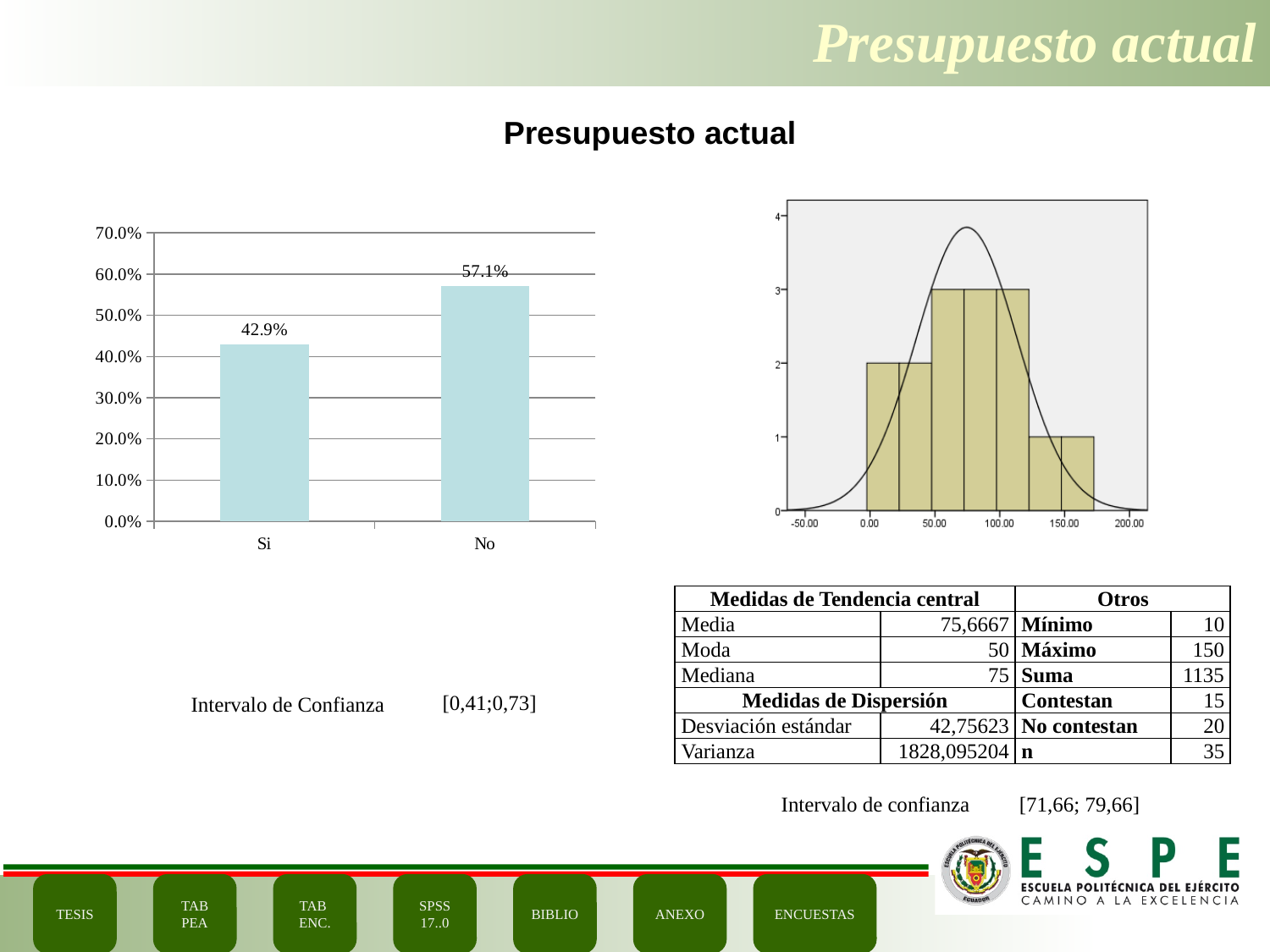
In the bar chart on the left, what is the value for "No"? 57.1% What is the title of the bar chart on the left? Presupuesto actual What kind of chart is the chart on the left of the slide? bar chart How many categories are shown in the bar chart on the left? 2 In the bar chart on the left, what is the difference between the values for "No" and "Si"? 14.2% In the bar chart on the left, which category has the lowest value? Si How many bars are there in the histogram on the right? 7 In the bar chart on the left, which is larger, the value for "Si" or the value for "No"? No In the bar chart on the left, is the value for "Si" greater or less than 50.0%? less In the bar chart on the left, which category has the highest value? No In the histogram on the right, what is the highest bar height shown on the y axis? 3 In the bar chart on the left, what is the value for "Si"? 42.9%